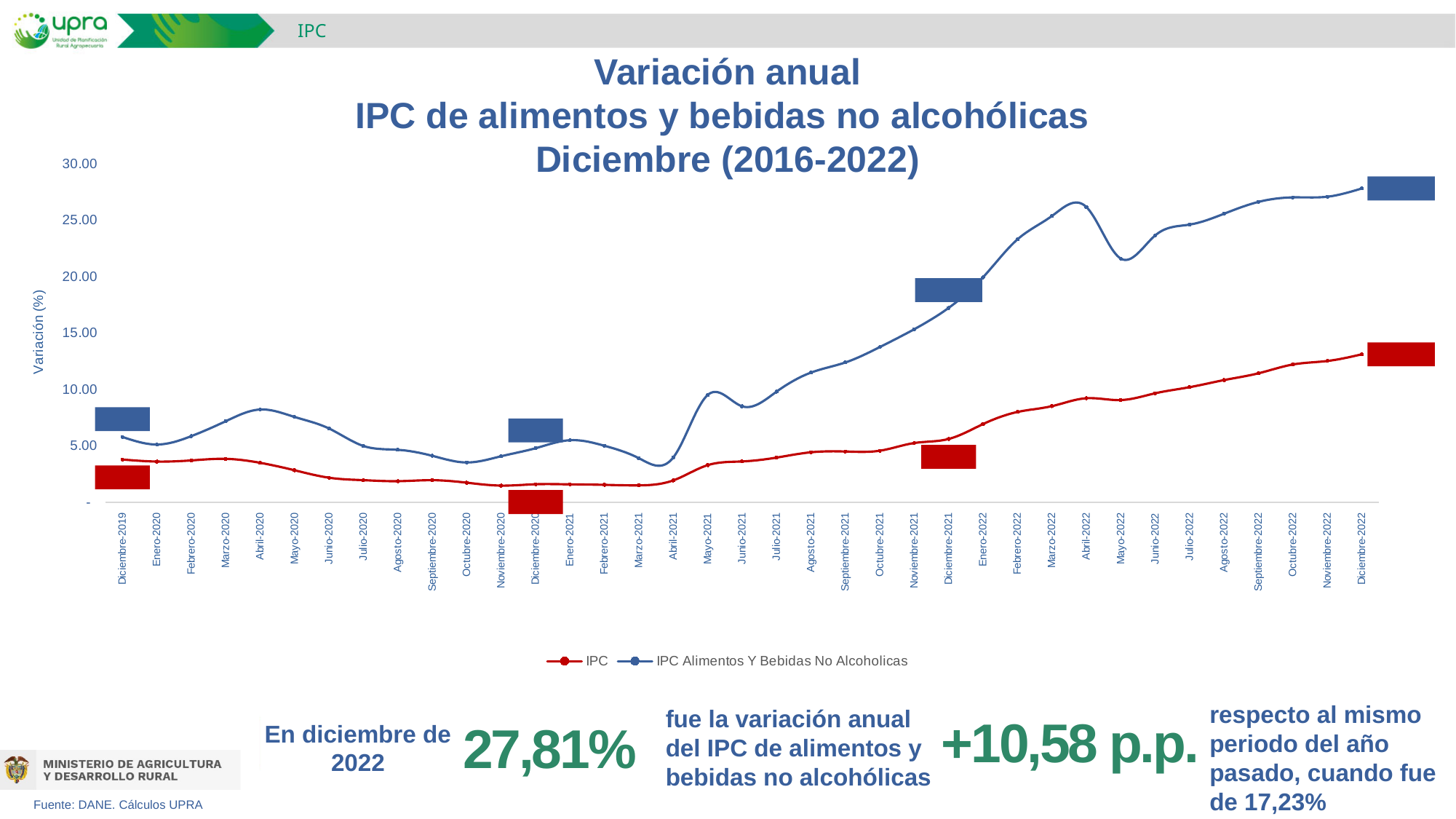
How many series does the legend list? 2 Is the value of the IPC series in Diciembre-2022 greater or less than 10.00? greater What was the annual variation of the IPC de alimentos y bebidas no alcohólicas in Diciembre-2022? 27,81% By how many percentage points did the IPC de alimentos y bebidas no alcohólicas annual variation in Diciembre-2022 exceed that of Diciembre-2021? +10,58 p.p. Which series has the higher value in Diciembre-2022, IPC or IPC Alimentos Y Bebidas No Alcoholicas? IPC Alimentos Y Bebidas No Alcoholicas What was the annual variation of the IPC de alimentos y bebidas no alcohólicas in Diciembre-2021? 17,23% What is the y-axis title of the chart? Variación (%) Does the IPC series rise or fall from Diciembre-2021 to Diciembre-2022? rise What kind of chart is shown on the slide? line chart Is the value of the IPC Alimentos Y Bebidas No Alcoholicas series in Abril-2021 greater or less than 5.00? less How many monthly points are plotted along the x axis? 37 What are the two series named in the legend? IPC; IPC Alimentos Y Bebidas No Alcoholicas